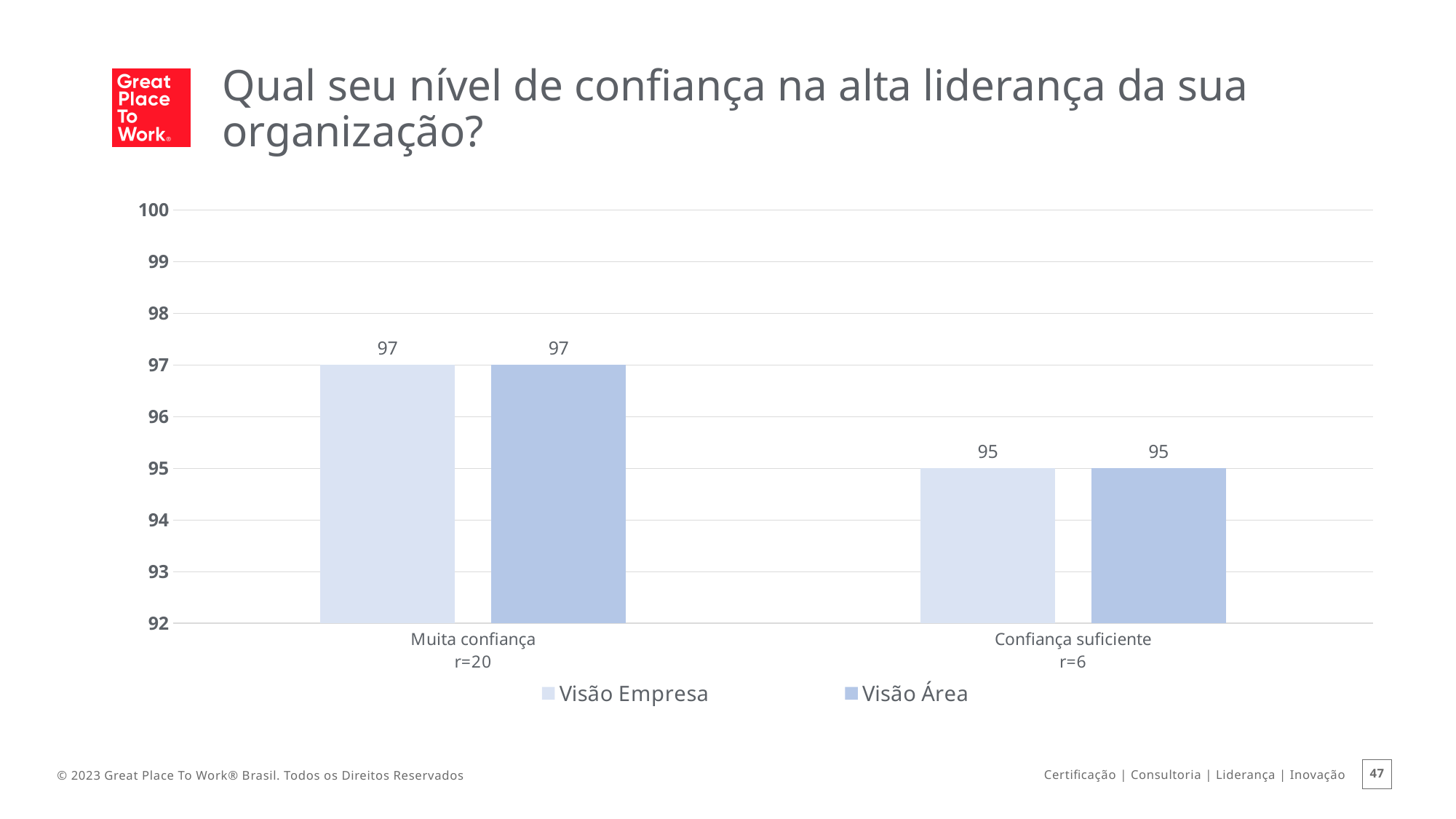
What is the value for Visão Empresa in the Confiança suficiente category? 95 Which category has the highest value for Visão Área? Muita confiança Which category has the lowest value for Visão Empresa? Confiança suficiente Is the value for Visão Área in Muita confiança greater or less than 96? greater What is the number of respondents (r) shown for the Confiança suficiente category? r=6 How many categories are shown on the x axis? 2 What is the difference between the Visão Empresa values for Muita confiança and Confiança suficiente? 2 What is the value for Visão Empresa in the Muita confiança category? 97 How many series does the legend list? 2 What kind of chart is shown on the slide? bar chart Which is larger: the Visão Área value for Muita confiança or for Confiança suficiente? Muita confiança What is the value for Visão Área in the Confiança suficiente category? 95